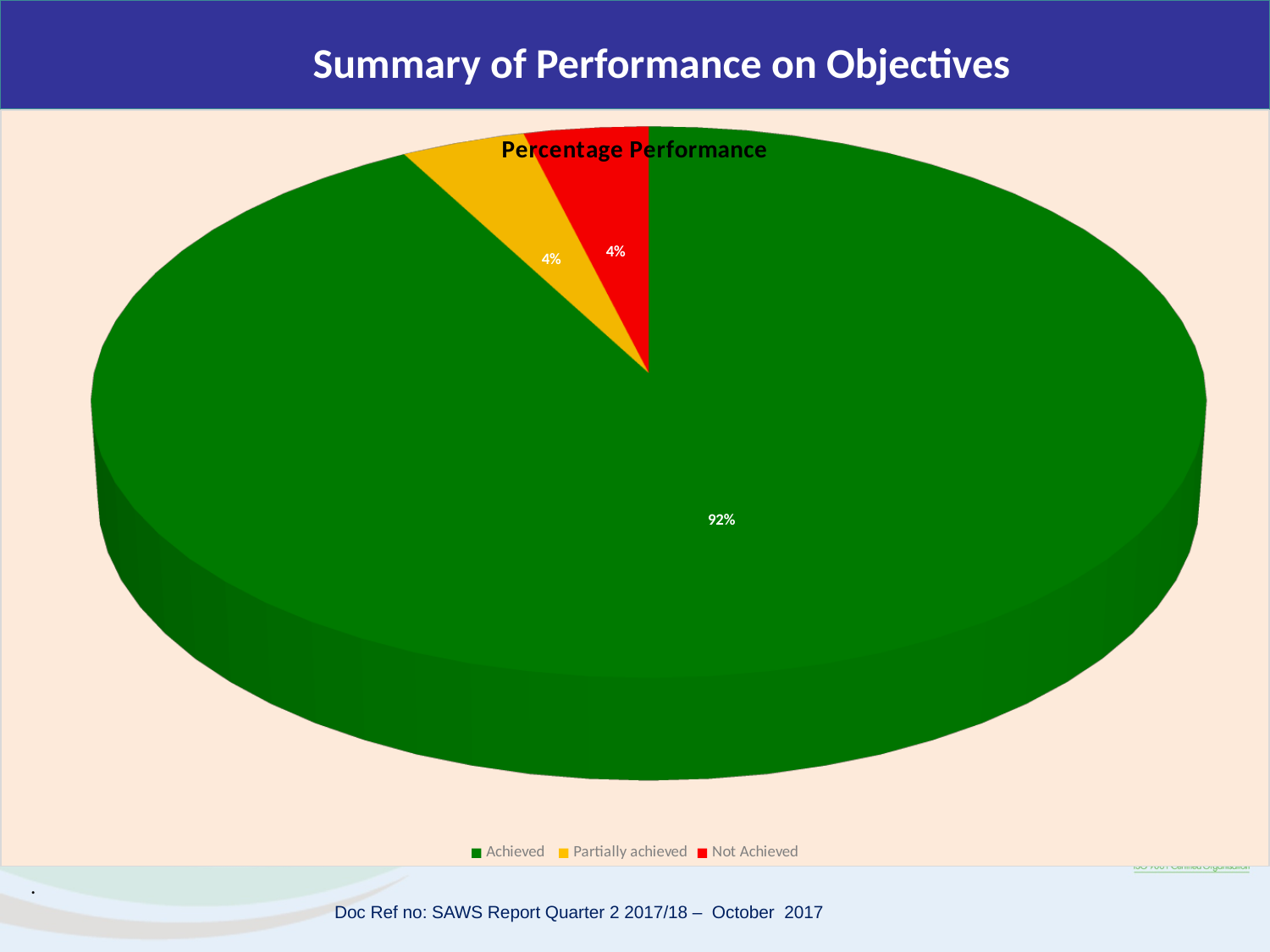
What type of chart is shown on the slide? Pie chart What percentage of objectives were Not Achieved? 4% Which is larger, the Achieved share or the Partially achieved share? Achieved What percentage of objectives were Achieved? 92% What percentage of objectives were Partially achieved? 4% What is the combined share of Partially achieved and Not Achieved? 8% What colour represents the Not Achieved category? Red Which category has the largest share of the pie? Achieved How many categories does the legend list? 3 What is the title of the chart? Percentage Performance What is the difference between the Achieved share and the Not Achieved share? 88%